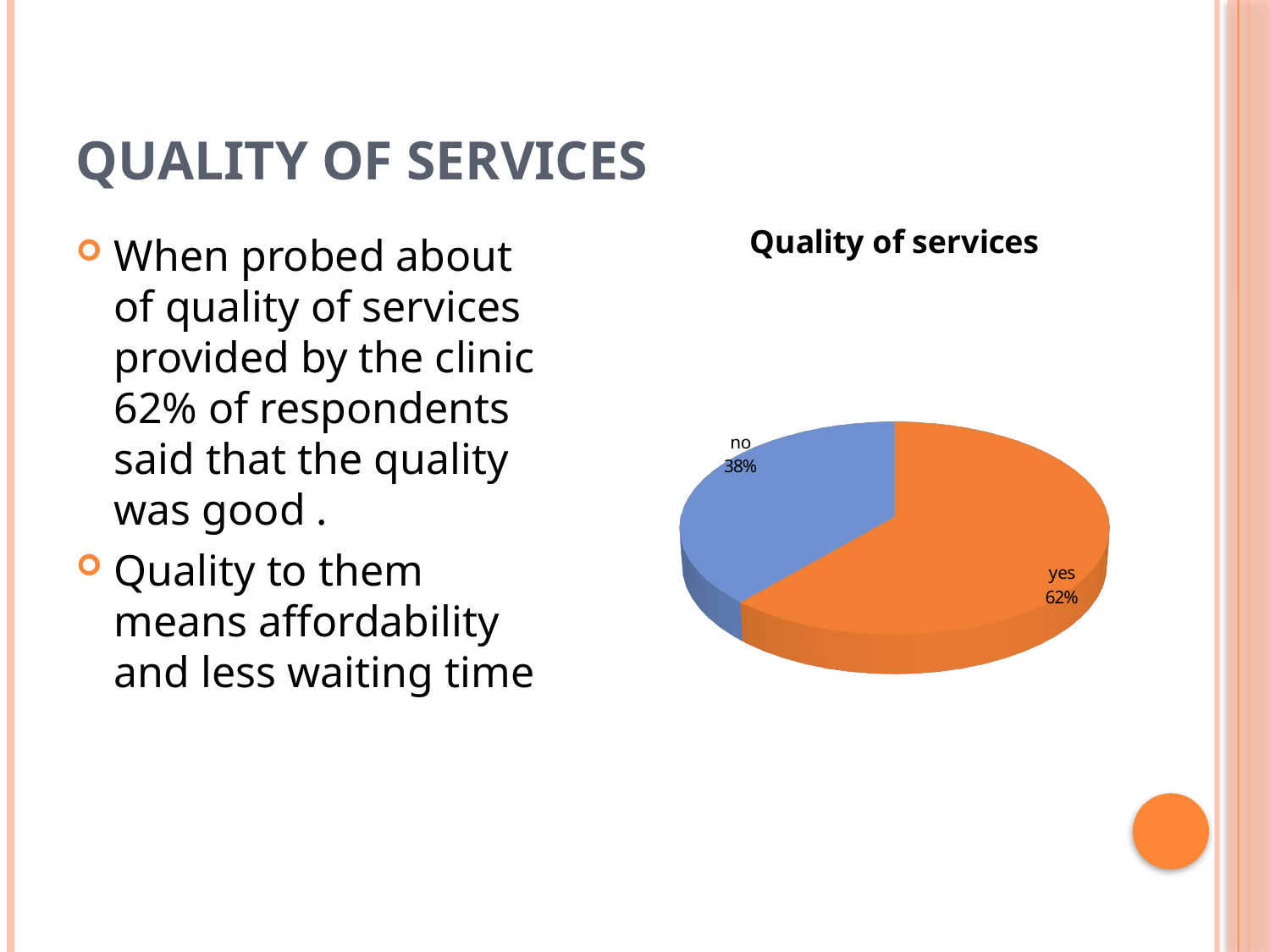
Which is larger, the "yes" slice or the "no" slice? yes What share of the pie does the "yes" slice represent? 62% Which slice is the largest in the pie chart? yes How many slices does the pie chart have? 2 What colour is the "yes" slice? orange Which slice is the smallest in the pie chart? no What kind of chart is shown on the slide? pie chart What is the difference in percentage points between the "yes" and "no" slices? 24 What is the title of the chart? Quality of services What share of the pie does the "no" slice represent? 38%